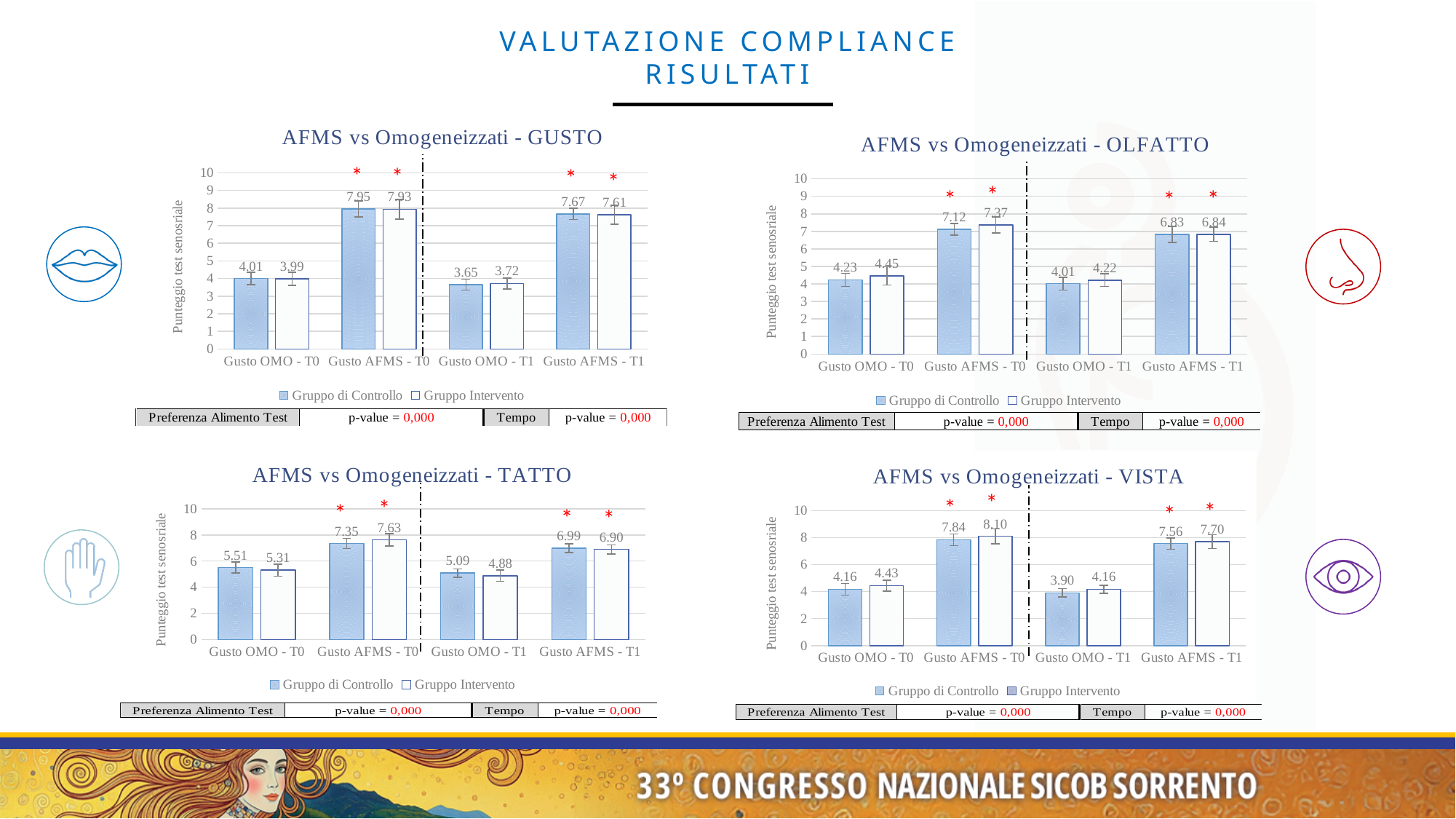
How many series does the legend of the 'AFMS vs Omogeneizzati - GUSTO' chart list? 2 In the 'AFMS vs Omogeneizzati - VISTA' chart, which category has the lowest value for Gruppo di Controllo? Gusto OMO - T1 What kind of chart is 'AFMS vs Omogeneizzati - OLFATTO'? bar chart How many categories are shown on the x axis of the 'AFMS vs Omogeneizzati - VISTA' chart? 4 In the 'AFMS vs Omogeneizzati - OLFATTO' chart, which is larger at Gusto AFMS - T0: Gruppo di Controllo or Gruppo Intervento? Gruppo Intervento In the 'AFMS vs Omogeneizzati - OLFATTO' chart, what is the value for Gruppo Intervento at Gusto OMO - T0? 4.45 What is the y-axis label of the 'AFMS vs Omogeneizzati - TATTO' chart? Punteggio test sensoriale In the 'AFMS vs Omogeneizzati - GUSTO' chart, what is the value for Gruppo di Controllo at Gusto AFMS - T0? 7.95 In the 'AFMS vs Omogeneizzati - VISTA' chart, which category has the highest value for Gruppo Intervento? Gusto AFMS - T0 In the 'AFMS vs Omogeneizzati - TATTO' chart, what is the value for Gruppo Intervento at Gusto OMO - T1? 4.88 In the 'AFMS vs Omogeneizzati - TATTO' chart, is the value for Gruppo di Controllo at Gusto OMO - T0 greater or less than 4? greater In the 'AFMS vs Omogeneizzati - GUSTO' chart, what is the difference between Gruppo di Controllo at Gusto AFMS - T0 and at Gusto OMO - T0? 3.94